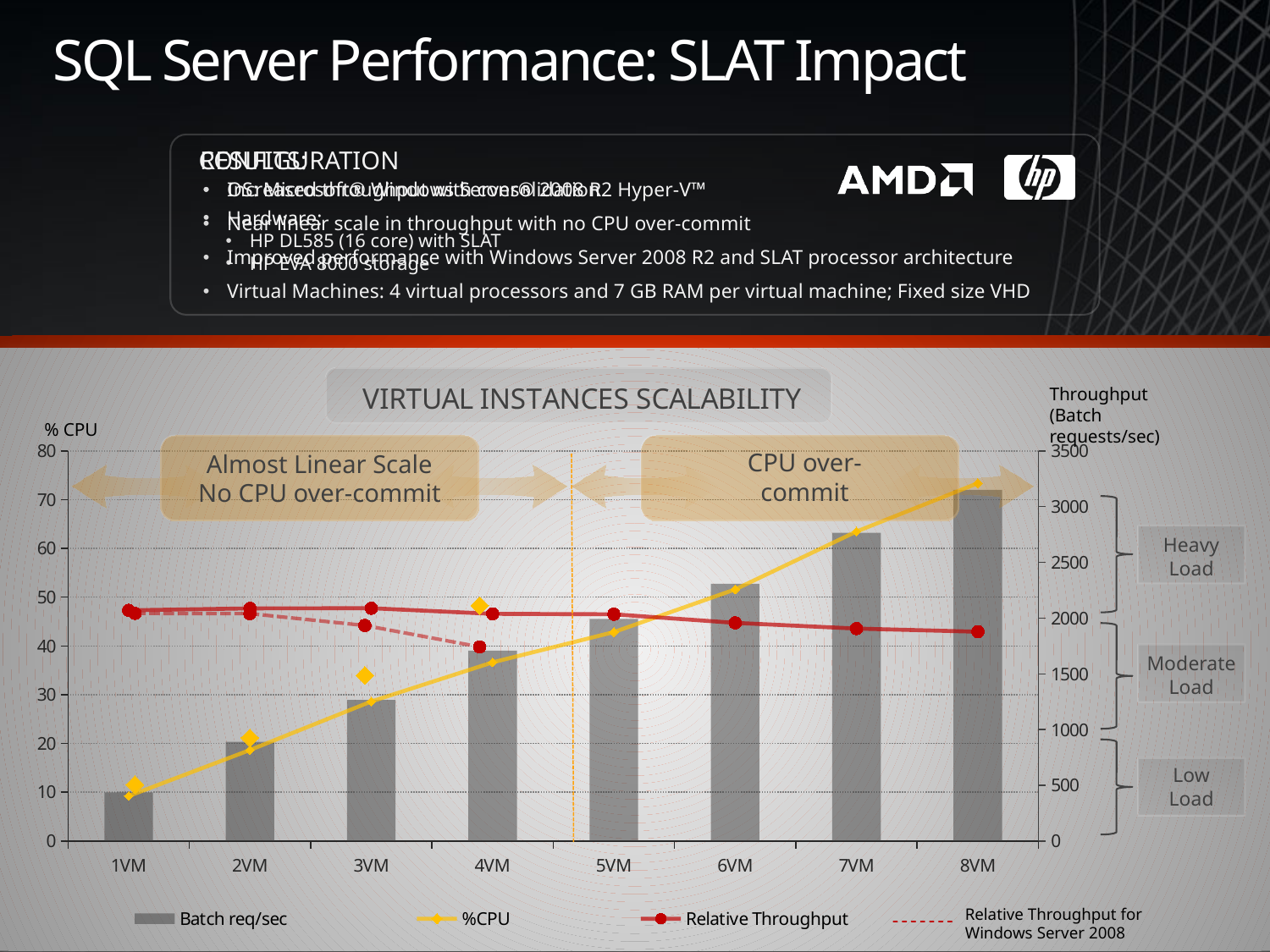
Which VM category has the lowest Batch req/sec bar? 1VM Does the Relative Throughput line rise or fall from 1VM to 8VM? Fall Is the %CPU value for 8VM greater or less than 60? greater Which has the larger Batch req/sec bar, 3VM or 6VM? 6VM How many series does the chart legend list? 4 Do the Batch req/sec bars rise or fall from 1VM to 8VM? Rise What is the title of the chart on the slide? VIRTUAL INSTANCES SCALABILITY Is the Batch req/sec value for 8VM greater or less than 2500 on the Throughput axis? greater Is the Batch req/sec value for 1VM greater or less than 1000 on the Throughput axis? less Which VM category has the highest Batch req/sec bar? 8VM How many VM categories are shown on the x axis of the chart? 8 What kind of chart is shown on the slide? Combined bar and line chart